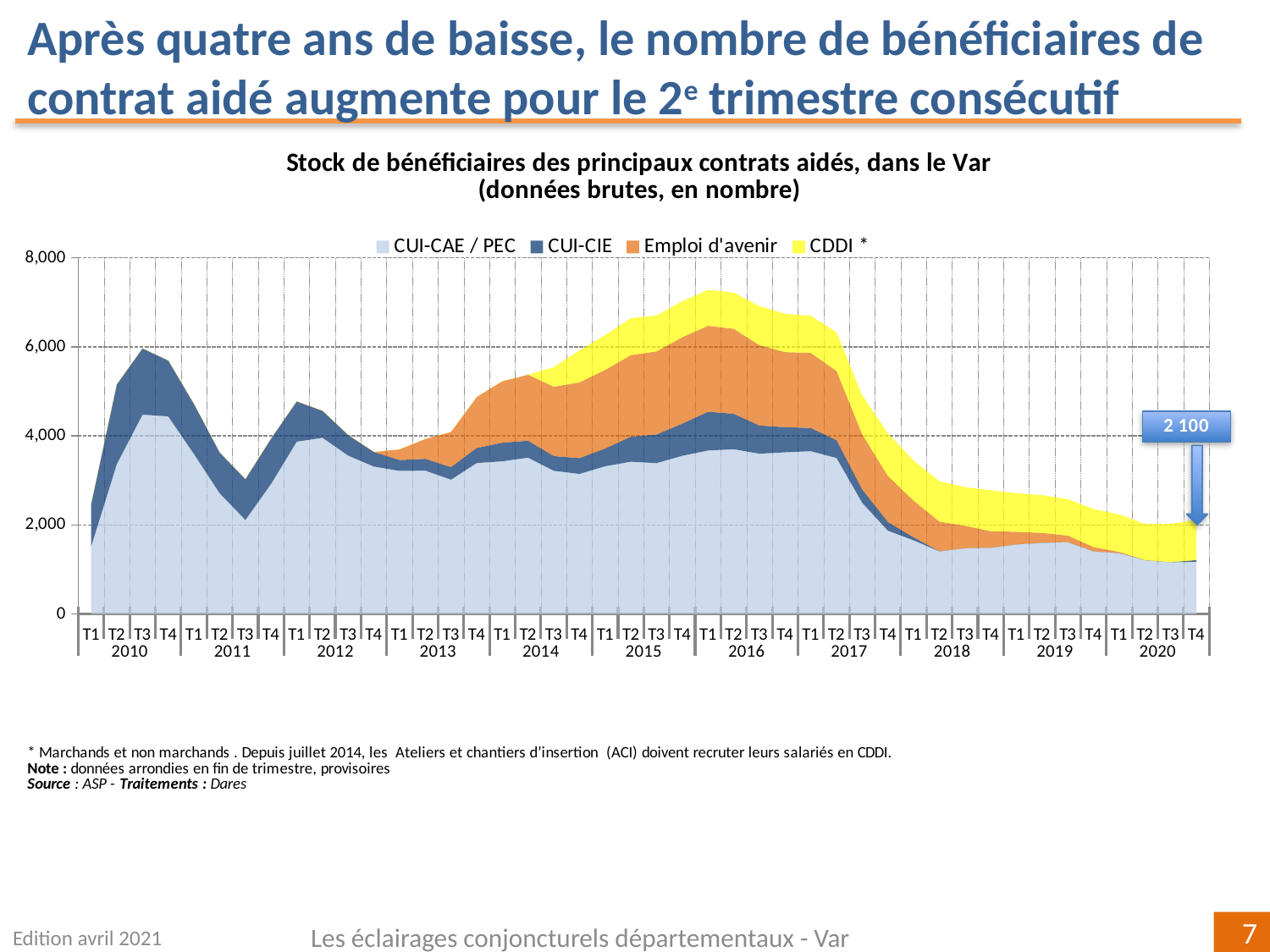
Is the total stock in T3 2011 greater or less than 4,000? less Does the total stock rise or fall between T1 2016 and T4 2017? fall Is the total stock in T4 2018 greater or less than 4,000? less Is the total stock in T1 2016 greater or less than 6,000? greater What kind of chart is shown on the slide? stacked area chart What total value is labelled for T4 2020? 2 100 How many years are shown on the x axis? 11 Which series are listed in the legend? CUI-CAE / PEC, CUI-CIE, Emploi d'avenir, CDDI * Which is larger, the total stock in T1 2016 or in T3 2010? T1 2016 What is the title of the chart? Stock de bénéficiaires des principaux contrats aidés, dans le Var (données brutes, en nombre) How many series does the legend list? 4 In which year does the total stock reach its highest peak? 2016